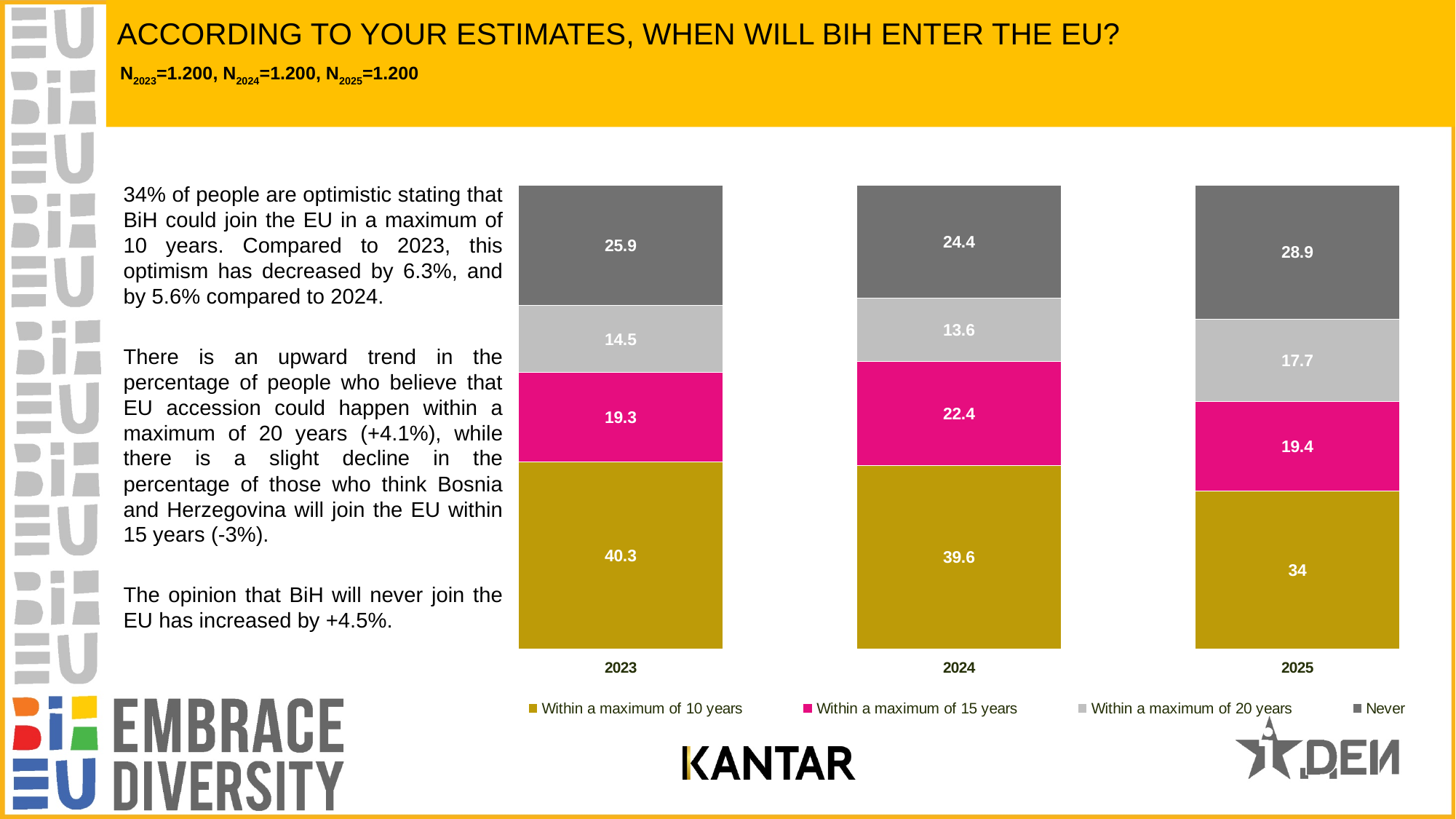
How many series does the legend list? 4 What is the value for 'Within a maximum of 15 years' in 2024? 22.4 What is the value for 'Within a maximum of 10 years' in 2025? 34 What is the value for 'Never' in 2023? 25.9 What is the difference between the 'Never' values for 2025 and 2024? 4.5 What is the total of the stacked bar for 2024? 100 What kind of chart is shown on the slide? Stacked bar chart What is the value for 'Within a maximum of 20 years' in 2025? 17.7 How many years (categories) are shown on the x axis? 3 Which is larger: 'Within a maximum of 15 years' in 2023 or in 2025? 2025 In which year is the 'Within a maximum of 10 years' value highest? 2023 In which year is the 'Within a maximum of 20 years' value lowest? 2024